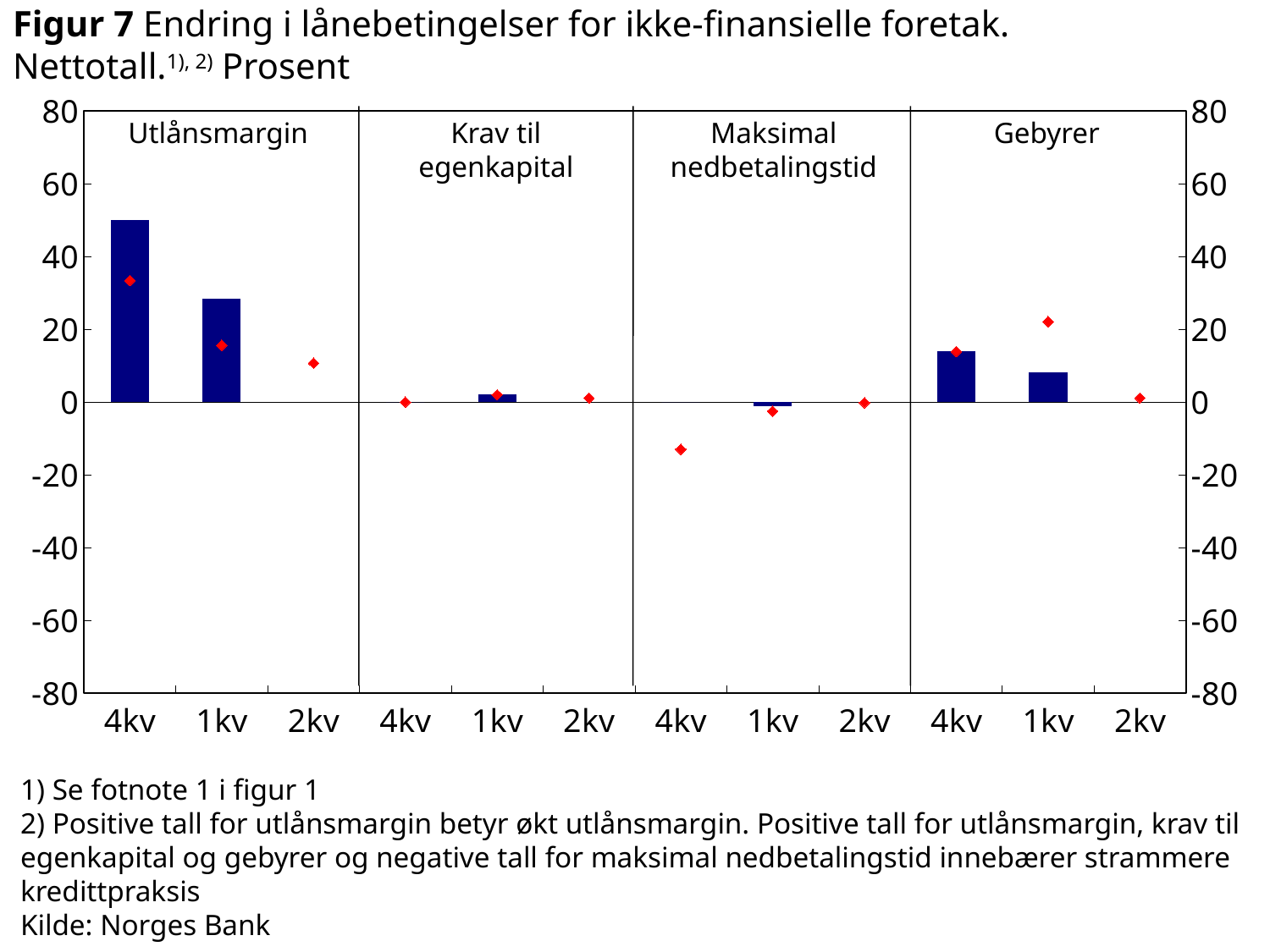
Is the bar for 4kv in the Utlånsmargin panel greater or less than 40? greater Which panel has a bar that extends below zero? Maksimal nedbetalingstid Is the bar for 4kv in the Gebyrer panel greater or less than 20? less Do the red diamonds in the Utlånsmargin panel rise or fall from 4kv to 2kv? fall Is the bar for 1kv in the Utlånsmargin panel greater or less than 20? greater In the Gebyrer panel, which bar is taller, 4kv or 1kv? 4kv What kind of chart is shown in Figur 7? bar chart Which panel contains the tallest bar in the chart? Utlånsmargin What is the source cited below the chart? Norges Bank How many panels (lending condition categories) does the chart have? 4 In the Utlånsmargin panel, which bar is taller, 4kv or 1kv? 4kv